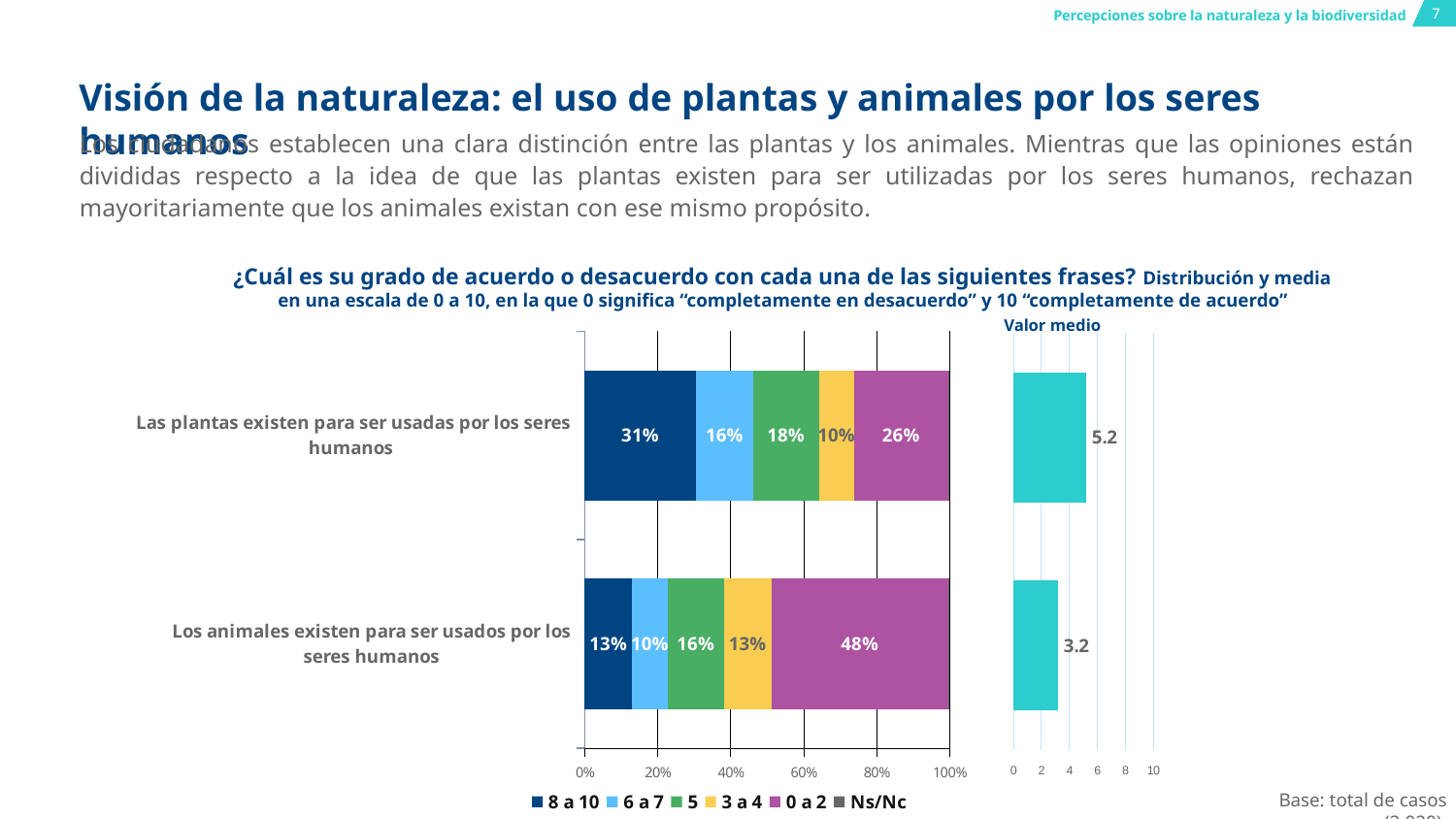
In the stacked bar chart, what percentage of respondents gave a score of 0 a 2 for 'Los animales existen para ser usados por los seres humanos'? 48% In the stacked bar chart, what percentage of respondents gave a score of 5 for 'Los animales existen para ser usados por los seres humanos'? 16% In the 'Valor medio' chart, what is the mean value for 'Las plantas existen para ser usadas por los seres humanos'? 5.2 In the 'Valor medio' chart, which statement has the higher mean value? Las plantas existen para ser usadas por los seres humanos In the stacked bar chart, what percentage of respondents gave a score of 8 a 10 for 'Las plantas existen para ser usadas por los seres humanos'? 31% In the 'Valor medio' chart, what is the difference between the mean values for the plants statement and the animals statement? 2.0 How many statements (categories) are shown in the stacked bar chart? 2 In the stacked bar chart, what is the difference between the 0 a 2 share for the animals statement and the 0 a 2 share for the plants statement? 22% In the 'Valor medio' chart, what is the mean value for 'Los animales existen para ser usados por los seres humanos'? 3.2 In the stacked bar chart, which statement has the larger 8 a 10 share: the plants statement or the animals statement? Las plantas existen para ser usadas por los seres humanos How many series does the legend of the stacked bar chart list? 6 What kind of chart is used to show the distribution of responses? Stacked bar chart